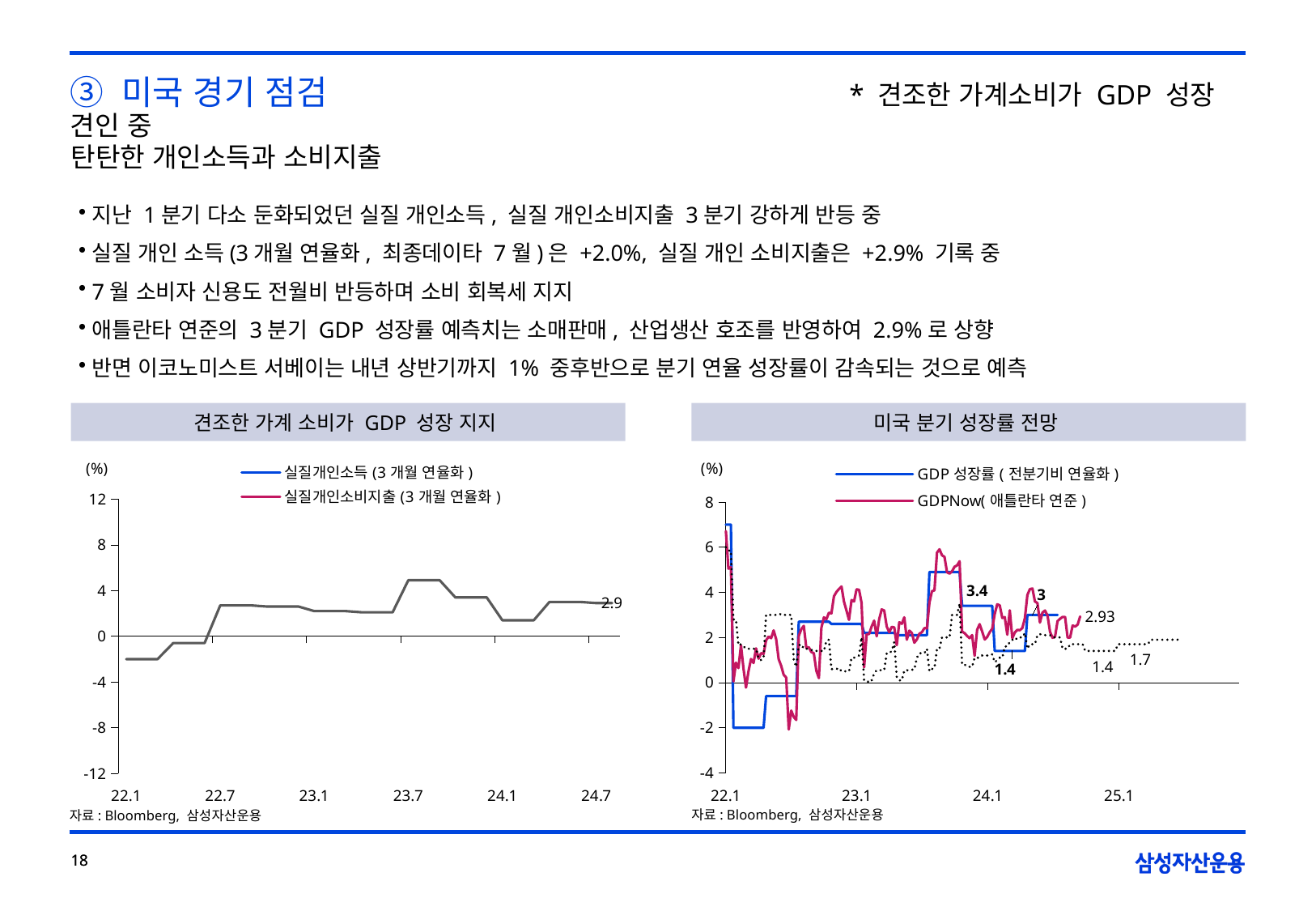
What is the maximum value shown on the y axis of the right chart '미국 분기 성장률 전망'? 8 In the right chart '미국 분기 성장률 전망', what is the latest value labeled on the GDPNow(애틀란타 연준) line? 2.93 How many series does the legend of the right chart '미국 분기 성장률 전망' list? 2 How many series does the legend of the left chart '견조한 가계 소비가 GDP 성장 지지' list? 2 What source is cited below the left chart '견조한 가계 소비가 GDP 성장 지지'? Bloomberg, 삼성자산운용 In the right chart '미국 분기 성장률 전망', what is the difference between the labeled values 3.4 and 1.4 on the GDP 성장률 line? 2 In the right chart '미국 분기 성장률 전망', which labeled value on the GDP 성장률 line is larger, 3.4 or 1.4? 3.4 In the right chart '미국 분기 성장률 전망', is the lowest value of the GDP 성장률 (전분기비 연율화) line greater or less than 0? less In the left chart '견조한 가계 소비가 GDP 성장 지지', what is the value printed at the end of the line? 2.9 In the left chart '견조한 가계 소비가 GDP 성장 지지', is the value at 22.1 greater or less than 0? less What kind of chart is the left chart titled '견조한 가계 소비가 GDP 성장 지지'? line chart What kind of chart is the right chart titled '미국 분기 성장률 전망'? line chart